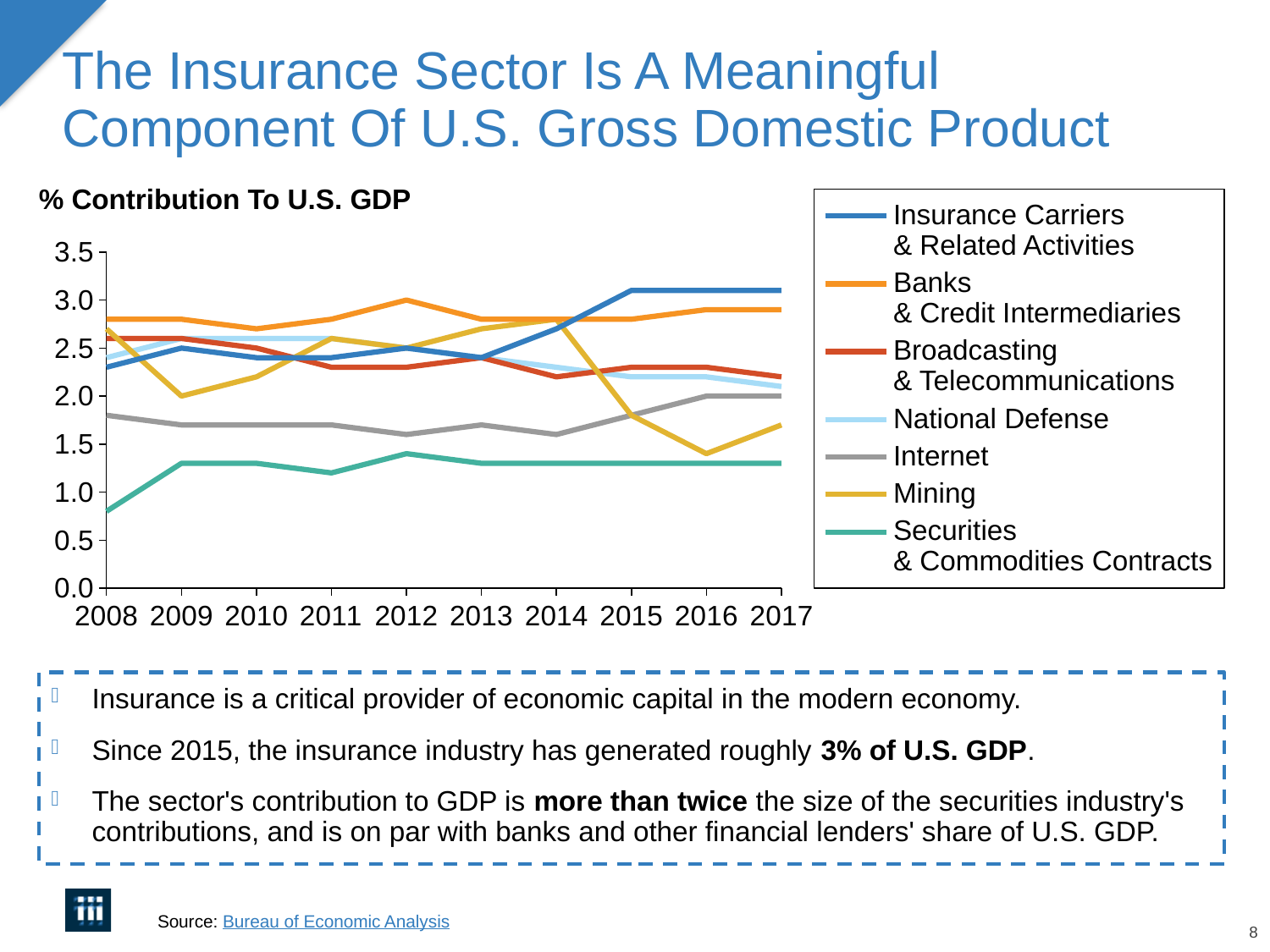
What is the title of the chart? % Contribution To U.S. GDP Is the value for Internet in 2012 greater or less than 2.0? less What kind of chart is shown on the slide? line chart Which series has the lowest value in 2017? Securities & Commodities Contracts Is the value for Securities & Commodities Contracts in 2008 greater or less than 1.0? less Does the Mining line rise or fall from 2014 to 2016? fall Which series has the highest value in 2017? Insurance Carriers & Related Activities How many years are shown along the x axis? 10 Is the value for Insurance Carriers & Related Activities in 2017 greater or less than 2.5? greater Does the Insurance Carriers & Related Activities line rise or fall from 2013 to 2015? rise In 2015, which is larger: Insurance Carriers & Related Activities or Banks & Credit Intermediaries? Insurance Carriers & Related Activities How many series does the legend list? 7